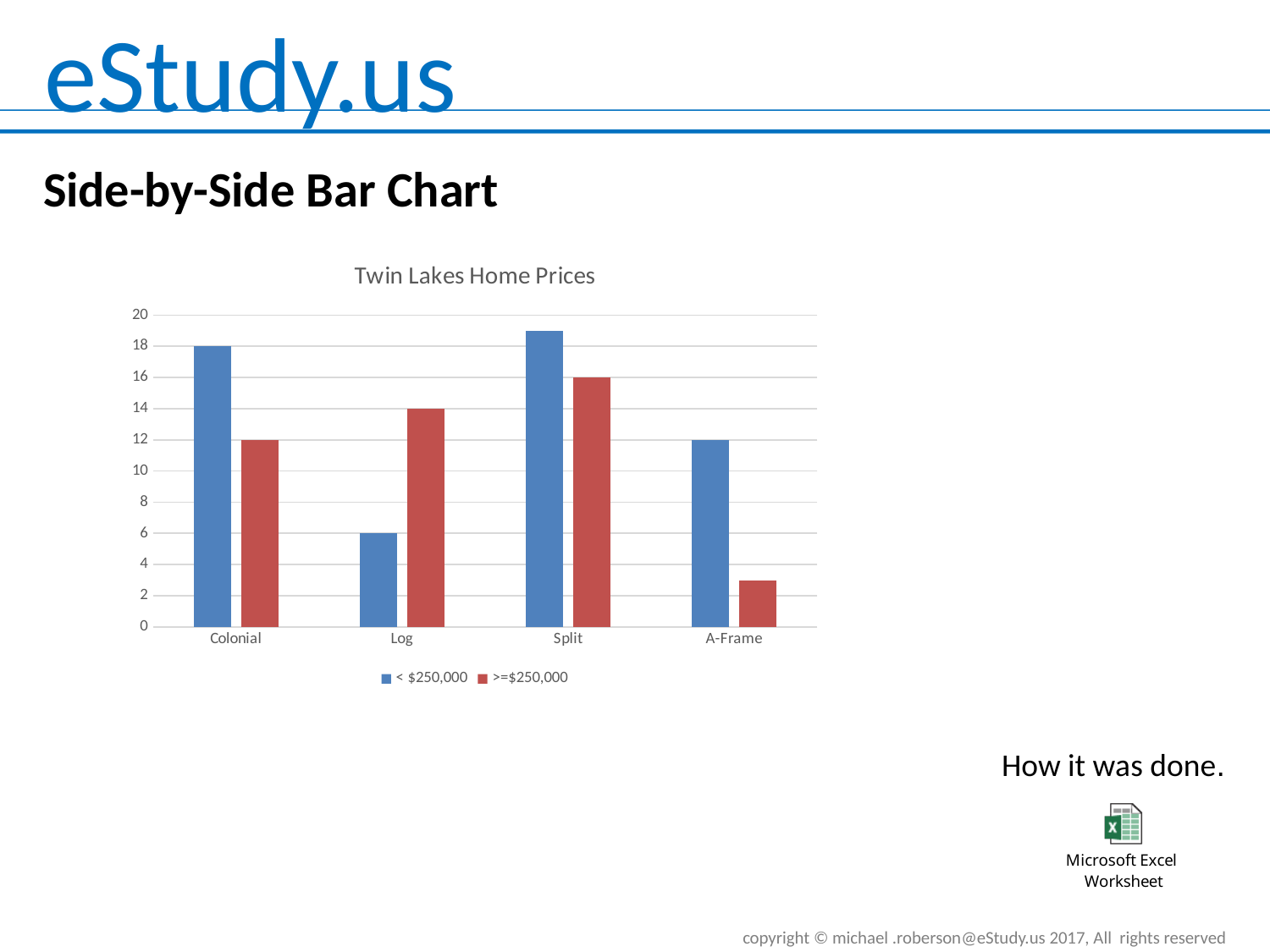
How many home-type categories are shown on the x axis? 4 Which category has the highest >=$250,000 bar? Split What is the value of the < $250,000 bar for Colonial? 18 How many series does the legend of the Twin Lakes Home Prices chart list? 2 What kind of chart is shown on the slide? bar chart What is the value of the >=$250,000 bar for Log? 14 For Log, which series has the larger bar, < $250,000 or >=$250,000? >=$250,000 Is the value of the >=$250,000 bar for A-Frame greater or less than 4? less What is the difference between the < $250,000 and >=$250,000 bars for Colonial? 6 Which category has the lowest < $250,000 bar? Log Is the value of the < $250,000 bar for Split greater or less than 18? greater What is the value of the >=$250,000 bar for Split? 16